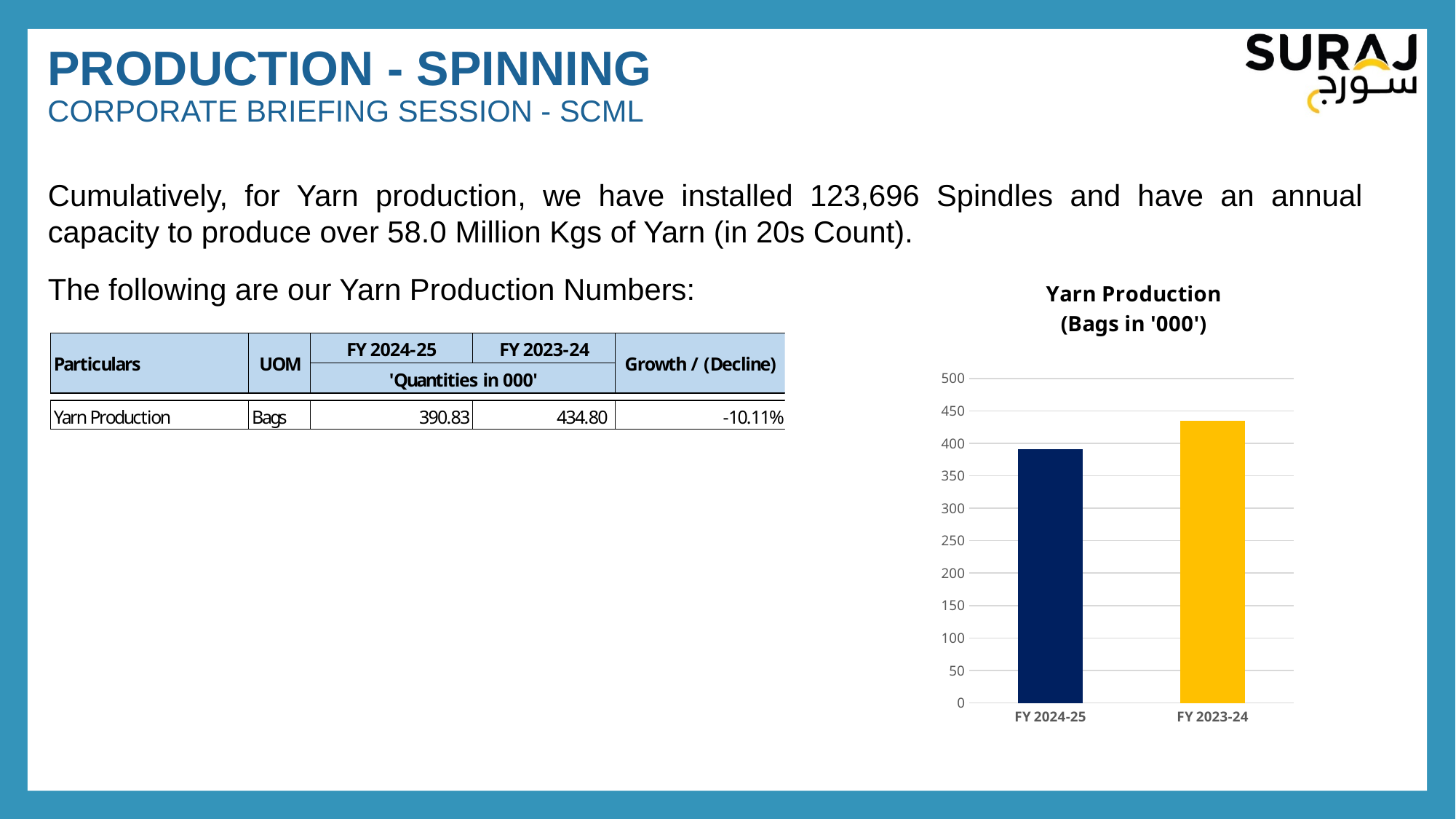
What is the Yarn Production value for FY 2024-25 in bags ('000), as printed in the table on the slide? 390.83 How many bars are plotted in the Yarn Production chart? 2 In the Yarn Production chart, is the bar for FY 2023-24 greater or less than 450? less What is the unit stated in the subtitle of the Yarn Production chart? Bags in '000' What is the Yarn Production value for FY 2023-24 in bags ('000), as printed in the table on the slide? 434.80 Is the Yarn Production value for FY 2024-25 larger or smaller than the value for FY 2023-24? smaller In the Yarn Production chart, is the bar for FY 2024-25 greater or less than 400? less In the Yarn Production chart, is the bar for FY 2023-24 greater or less than 400? greater Which fiscal year has the taller bar in the Yarn Production chart? FY 2023-24 What colour is the FY 2023-24 bar in the Yarn Production chart? yellow What kind of chart is the Yarn Production chart? bar chart Which fiscal year has the shorter bar in the Yarn Production chart? FY 2024-25